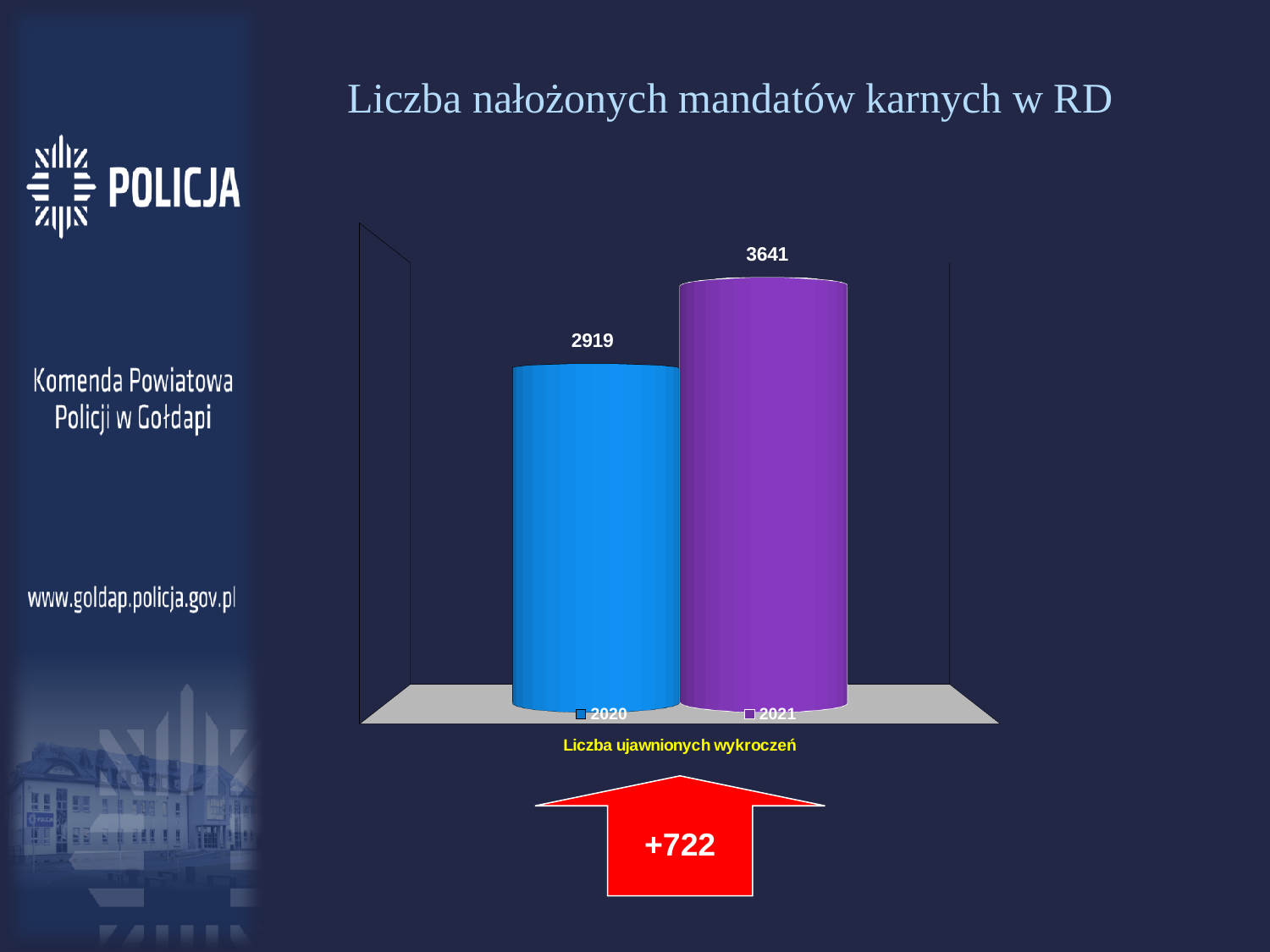
Which year has the higher value? 2021 Which year has the lower value? 2020 What is the difference between the 2021 and 2020 values? 722 How many series does the legend list? 2 What kind of chart is shown on the slide? Bar chart What colour is the bar for 2021? Purple What is the value for 2021? 3641 How many bars are shown in the chart? 2 Is the value for 2021 larger than the value for 2020? Yes Do the values rise or fall from 2020 to 2021? Rise What is the value for 2020? 2919 What is the title of the chart? Liczba nałożonych mandatów karnych w RD